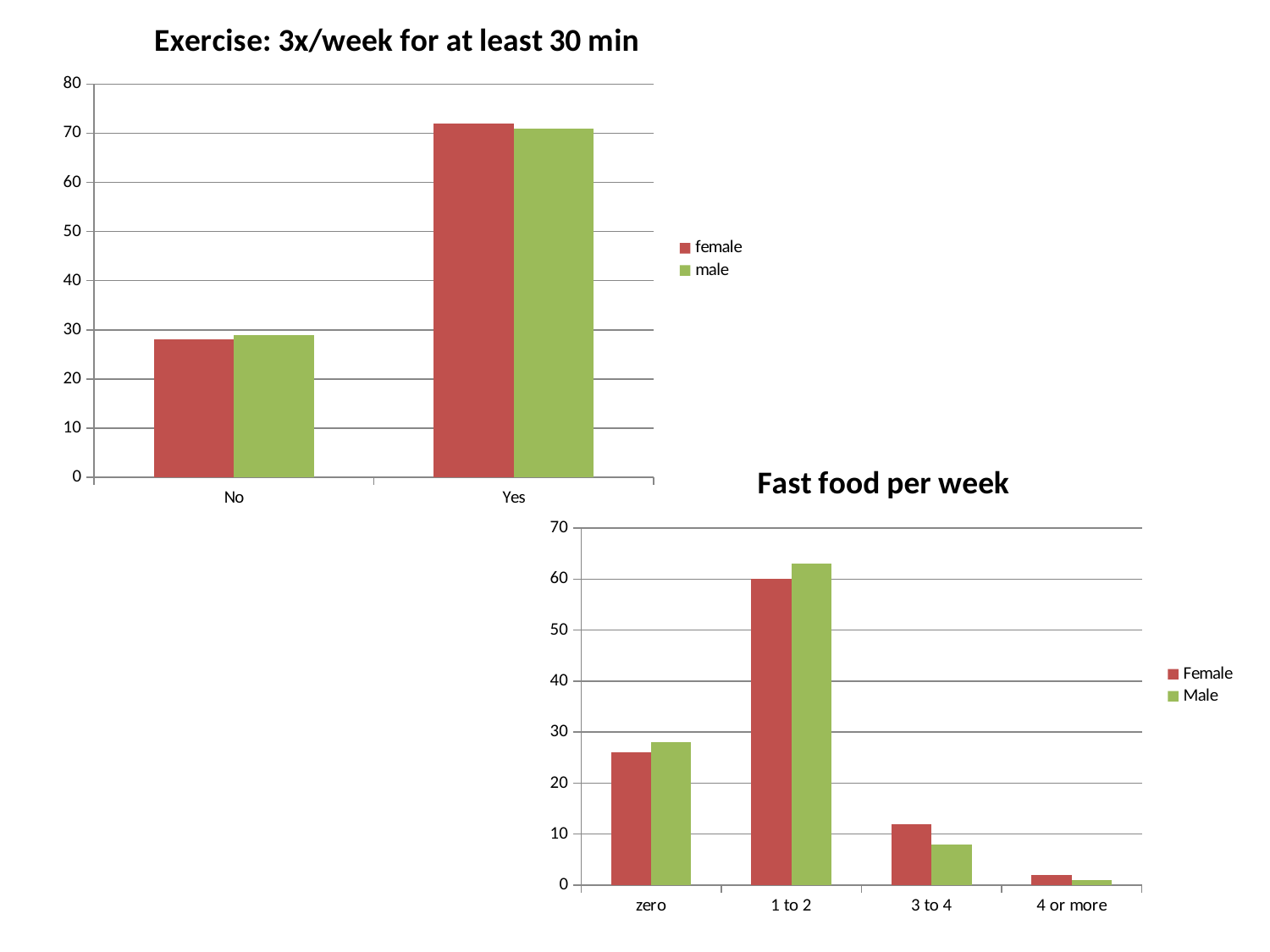
In the 'Exercise: 3x/week for at least 30 min' chart, is the female value for 'Yes' greater or less than 60? greater In the 'Exercise: 3x/week for at least 30 min' chart, what kind of chart is shown? bar chart In the 'Exercise: 3x/week for at least 30 min' chart, how many series does the legend list? 2 In the 'Fast food per week' chart, which category has the lowest Female value? 4 or more In the 'Fast food per week' chart, is the Male value for '1 to 2' greater or less than 50? greater In the 'Fast food per week' chart, what colour are the Male bars? green In the 'Fast food per week' chart, which category has the highest Male value? 1 to 2 In the 'Exercise: 3x/week for at least 30 min' chart, which category has the higher female value, 'No' or 'Yes'? Yes In the 'Fast food per week' chart, how many categories are shown on the x axis? 4 In the 'Exercise: 3x/week for at least 30 min' chart, is the male value for 'No' greater or less than 40? less In the 'Fast food per week' chart, which is larger for '3 to 4', the Female value or the Male value? Female In the 'Exercise: 3x/week for at least 30 min' chart, how many categories are shown on the x axis? 2